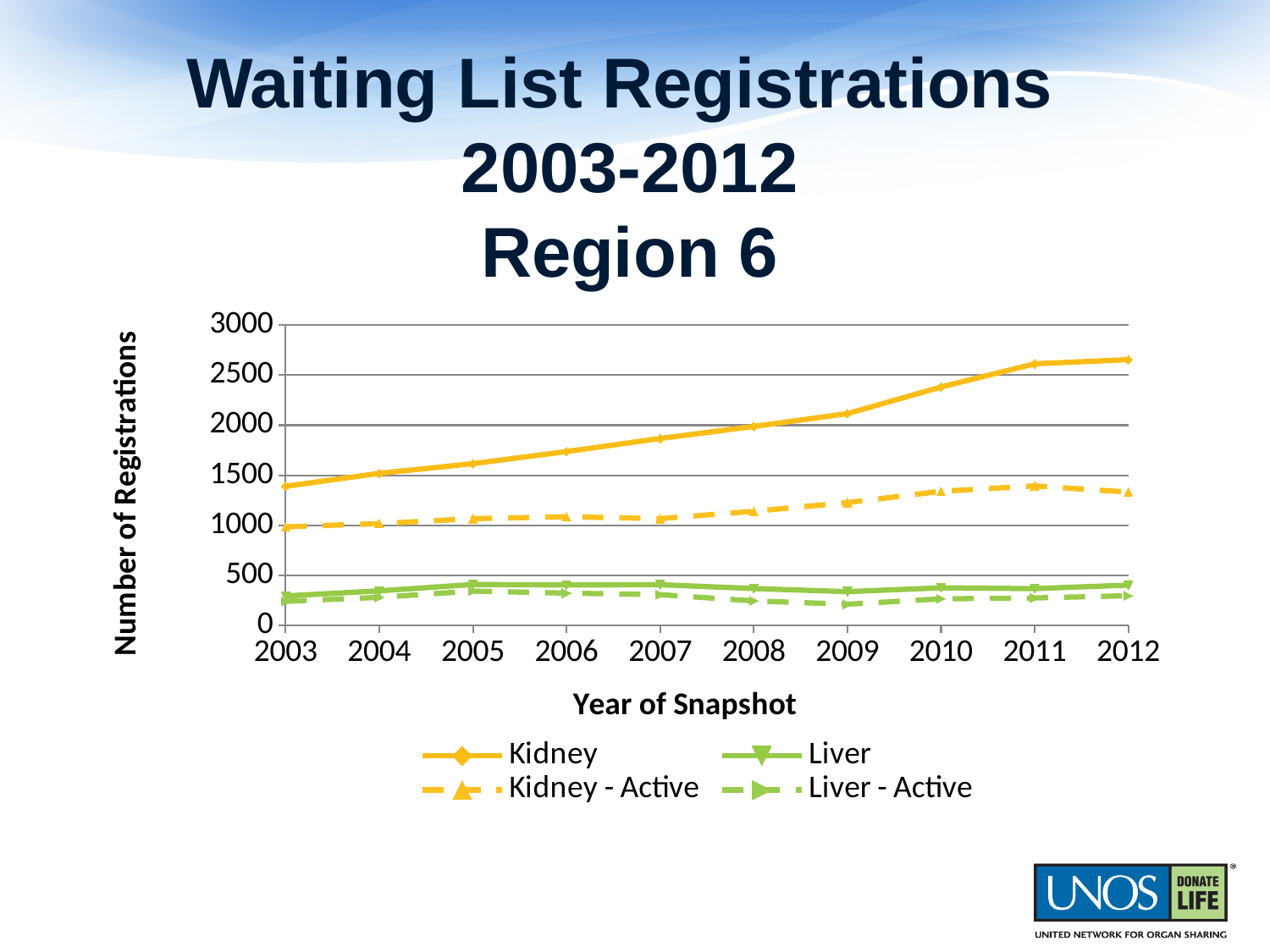
Does the Kidney series rise or fall from 2003 to 2012? Rise In 2012, which is larger: Kidney or Liver? Kidney How many series does the legend list? 4 What kind of chart is shown on the slide? Line chart Is the value for Kidney in 2003 greater or less than 1500? less How many years are plotted along the x axis? 10 Is the value for Kidney - Active in 2011 greater or less than 1500? less Is the value for Kidney in 2012 greater or less than 2500? greater What is the title of the x axis? Year of Snapshot Which series has the highest value in 2012? Kidney In which year is the Kidney series at its lowest? 2003